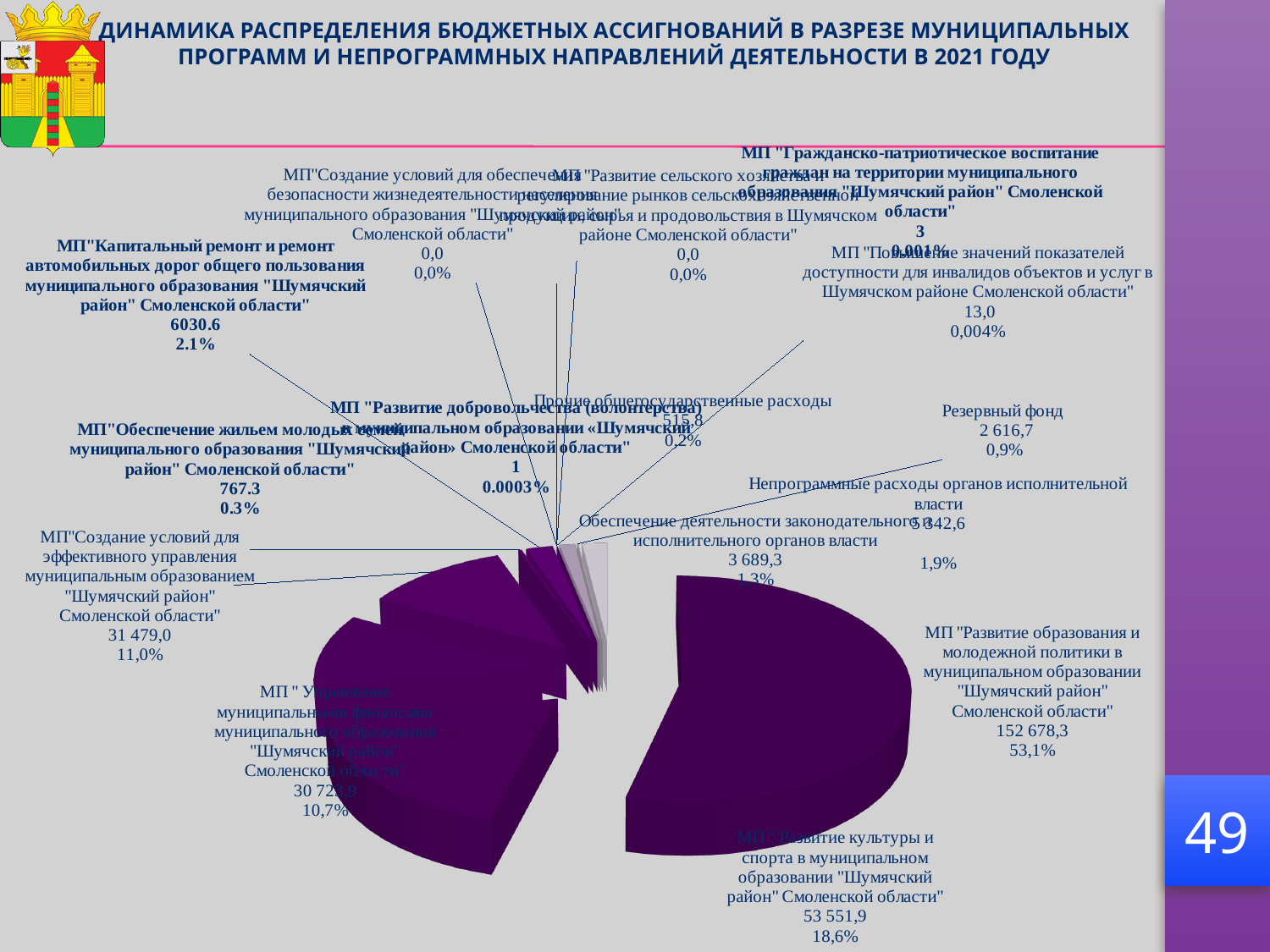
What value is shown for Резервный фонд? 2 616,7 What share of the pie does МП "Развитие образования и молодежной политики" have? 53,1% What share of the pie does МП "Создание условий для эффективного управления муниципальным образованием" have? 11,0% What value is shown for МП "Повышение значений показателей доступности для инвалидов объектов и услуг в Шумячском районе Смоленской области"? 13,0 Which is larger: the value for МП "Создание условий для эффективного управления муниципальным образованием" or the value for МП "Управление муниципальными финансами"? МП "Создание условий для эффективного управления муниципальным образованием" What kind of chart is shown on the slide? pie chart What year does the chart title say the budget allocation dynamics refer to? 2021 What is the difference between the values for Непрограммные расходы органов исполнительной власти (5 342,6) and Обеспечение деятельности законодательного и исполнительного органов власти (3 689,3)? 1 653,3 What value is shown for Непрограммные расходы органов исполнительной власти? 5 342,6 Which category has the largest share of the pie? МП "Развитие образования и молодежной политики в муниципальном образовании "Шумячский район" Смоленской области" What value is shown for МП "Развитие культуры и спорта в муниципальном образовании "Шумячский район" Смоленской области"? 53 551,9 What share of the pie does МП "Развитие культуры и спорта" have? 18,6%